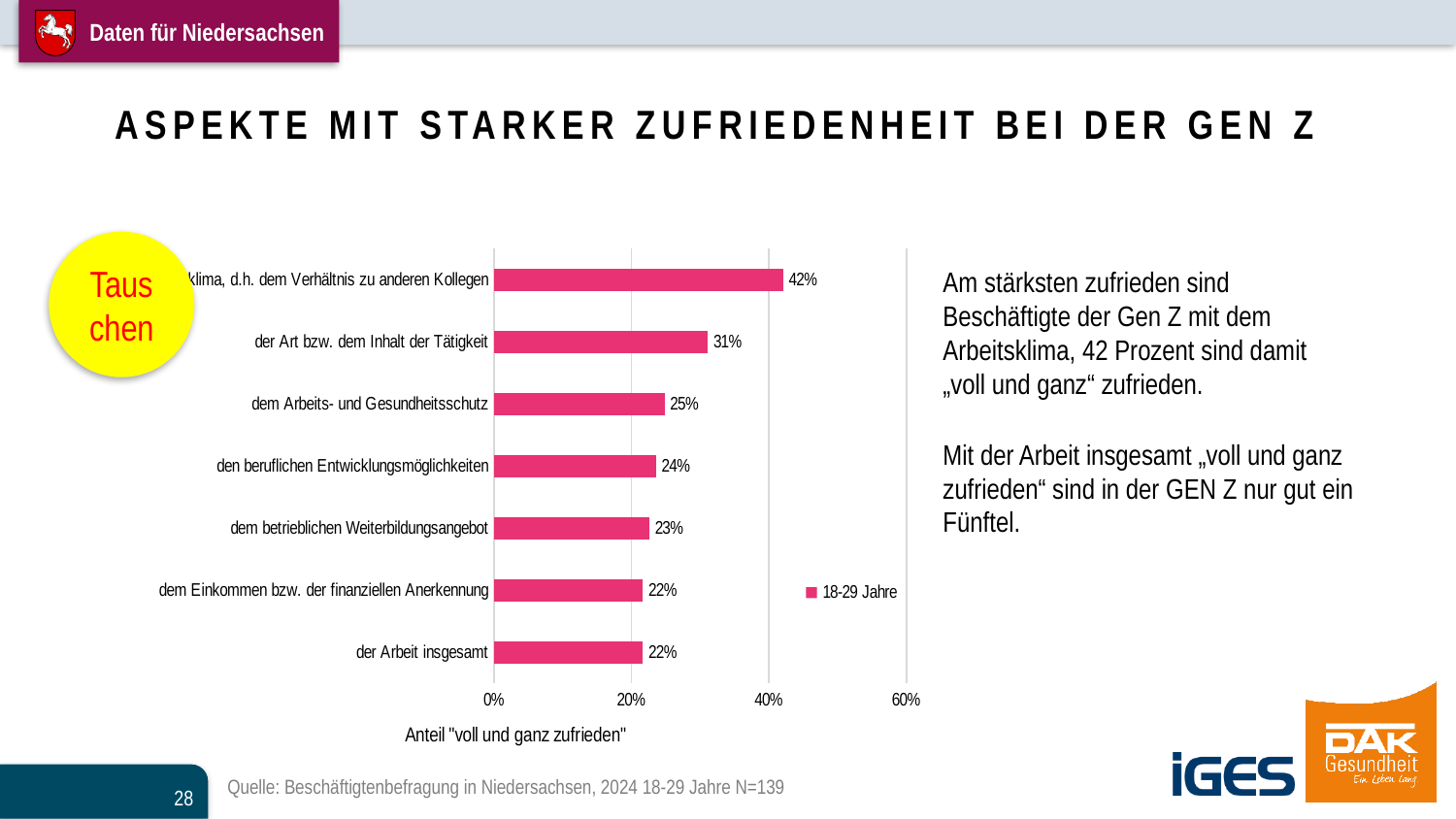
What value is shown for "der Art bzw. dem Inhalt der Tätigkeit"? 31% Which is larger: the value for "dem Arbeits- und Gesundheitsschutz" or for "dem Einkommen bzw. der finanziellen Anerkennung"? dem Arbeits- und Gesundheitsschutz What value is shown for "dem betrieblichen Weiterbildungsangebot"? 23% How many categories are shown in the chart? 7 What is the highest value shown in the chart? 42% Is the value for "der Art bzw. dem Inhalt der Tätigkeit" greater or less than 40%? less What value is shown for "der Arbeit insgesamt"? 22% What series does the chart legend list? 18-29 Jahre What kind of chart is shown on the slide? bar chart What value is shown for "dem Arbeits- und Gesundheitsschutz"? 25% What value is shown for "den beruflichen Entwicklungsmöglichkeiten"? 24% What is the difference between the values for "der Art bzw. dem Inhalt der Tätigkeit" and "der Arbeit insgesamt"? 9 percentage points